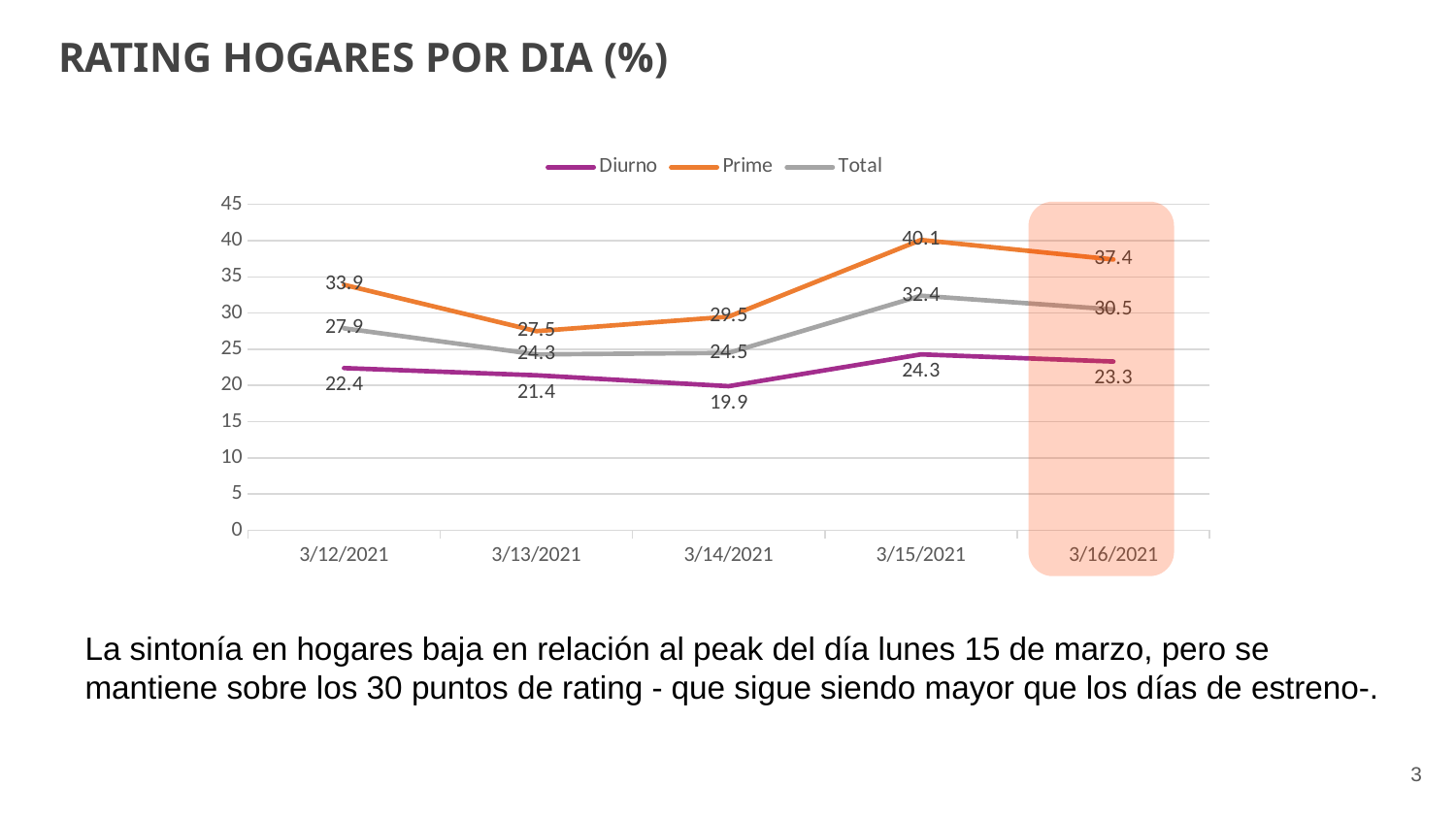
On which date is the Diurno rating lowest? 3/14/2021 How many dates are shown on the x axis? 5 What is the Total rating on 3/16/2021? 30.5 What is the difference between the Prime and Diurno ratings on 3/16/2021? 14.1 What is the Diurno rating on 3/14/2021? 19.9 On which date is the Prime rating highest? 3/15/2021 What is the title of the chart? RATING HOGARES POR DIA (%) What kind of chart is shown on the slide? Line chart How many series does the legend list? 3 Which is larger: the Total rating on 3/12/2021 or on 3/13/2021? 3/12/2021 Does the Prime rating rise or fall from 3/15/2021 to 3/16/2021? Fall What is the Prime rating on 3/15/2021? 40.1